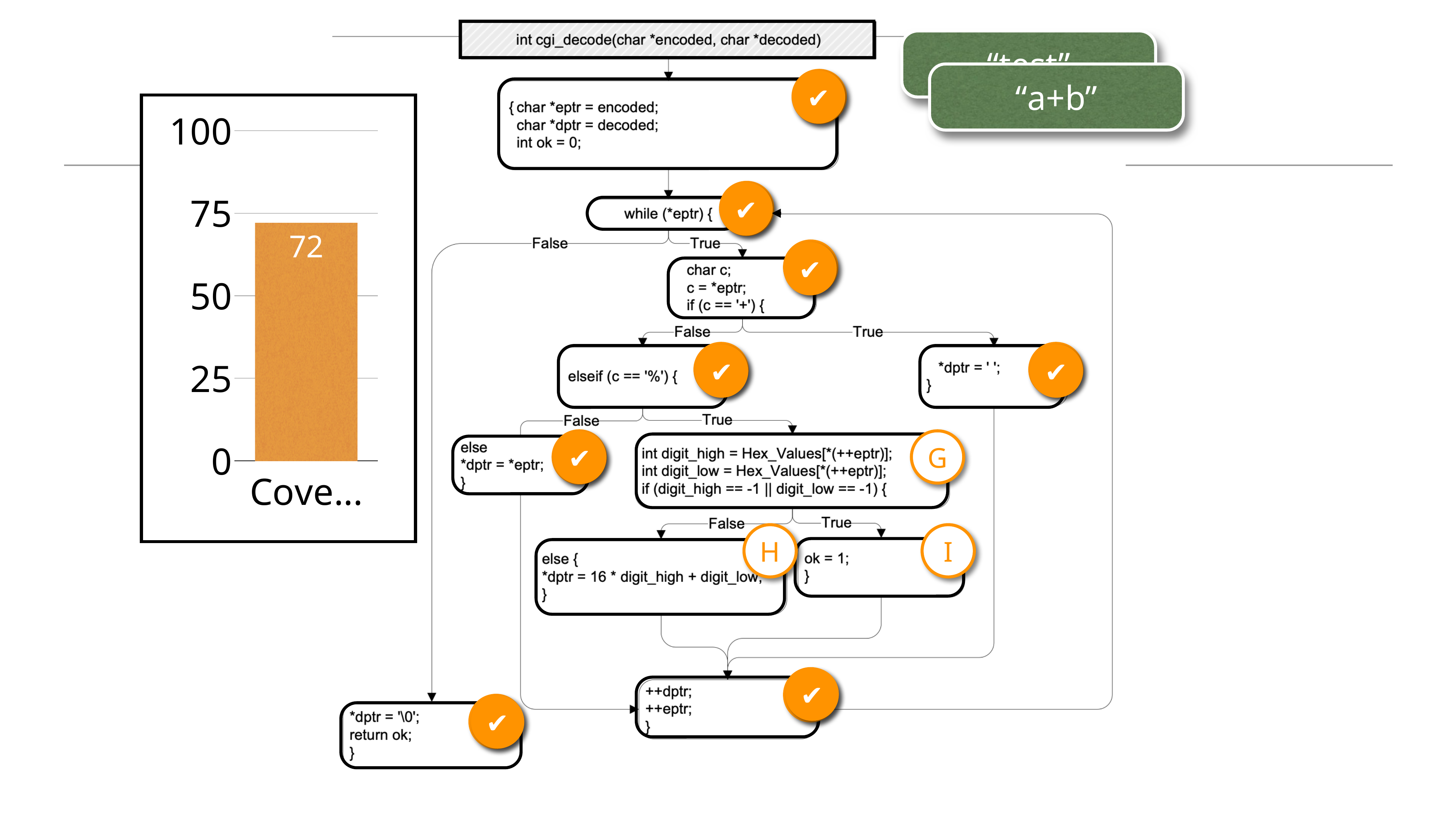
How many bars does the chart on the left of the slide show? 1 What is the lowest tick value shown on the vertical axis of the chart? 0 What value is printed on the bar in the chart on the left of the slide? 72 What is the highest tick value shown on the vertical axis of the chart? 100 Is the value of the bar in the chart greater or less than 50? greater Is the value of the bar in the chart greater or less than 75? less What kind of chart is shown on the left of the slide? bar chart How far below 100 is the value printed on the bar in the chart? 28